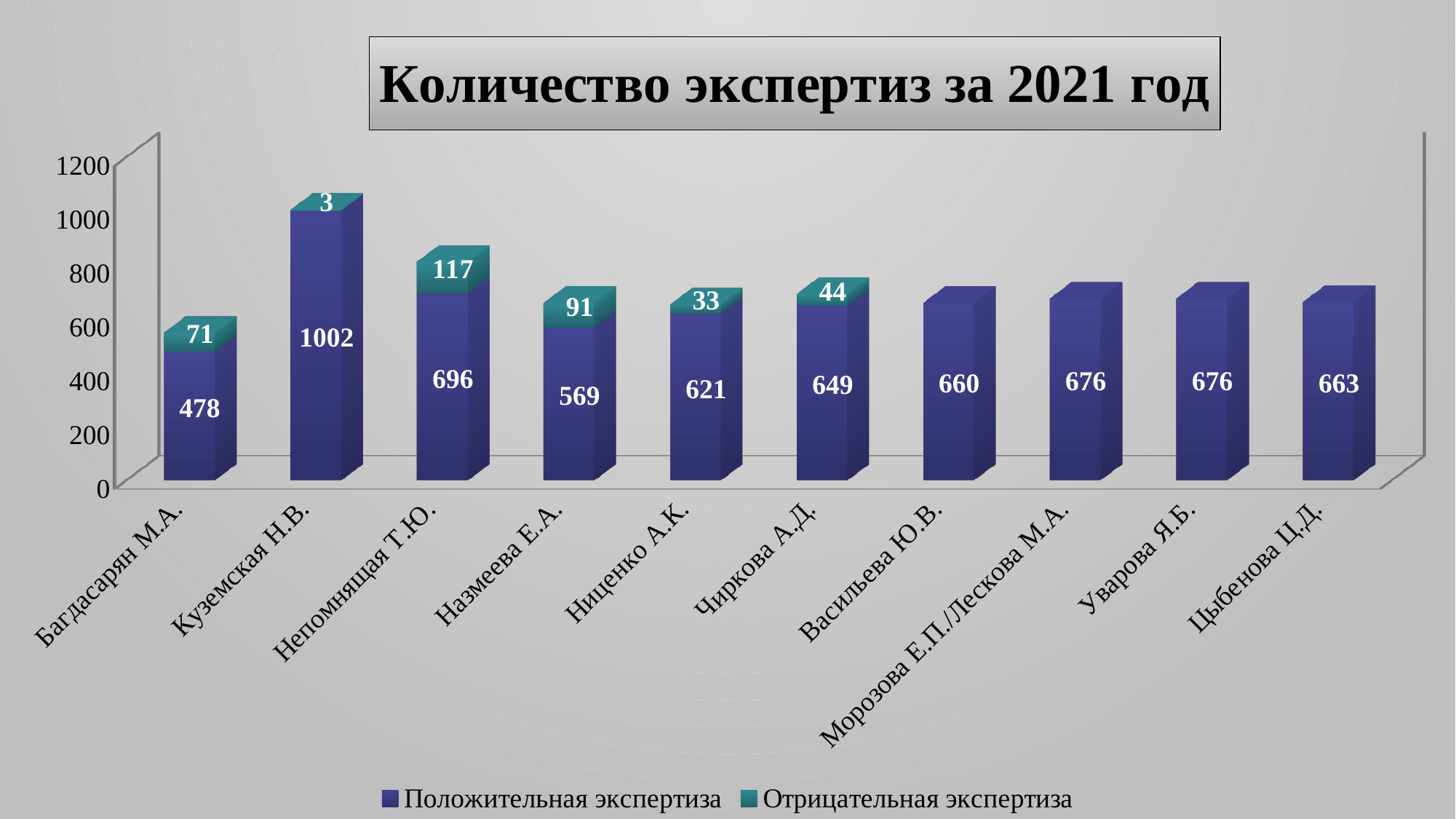
What is the value of Положительная экспертиза for Куземская Н.В.? 1002 What is the value of Положительная экспертиза for Цыбенова Ц.Д.? 663 Which category has the highest value of Отрицательная экспертиза? Непомнящая Т.Ю. What is the value of Отрицательная экспертиза for Непомнящая Т.Ю.? 117 How many categories are shown on the x axis? 10 What is the difference between the Положительная экспертиза values for Куземская Н.В. and Непомнящая Т.Ю.? 306 What is the title of the chart? Количество экспертиз за 2021 год How many series does the legend list? 2 Which category has the lowest value of Положительная экспертиза? Багдасарян М.А. Which is larger: the Положительная экспертиза value for Ниценко А.К. or for Чиркова А.Д.? Чиркова А.Д. What is the total of the stacked bar for Непомнящая Т.Ю.? 813 Which category has the highest value of Положительная экспертиза? Куземская Н.В.